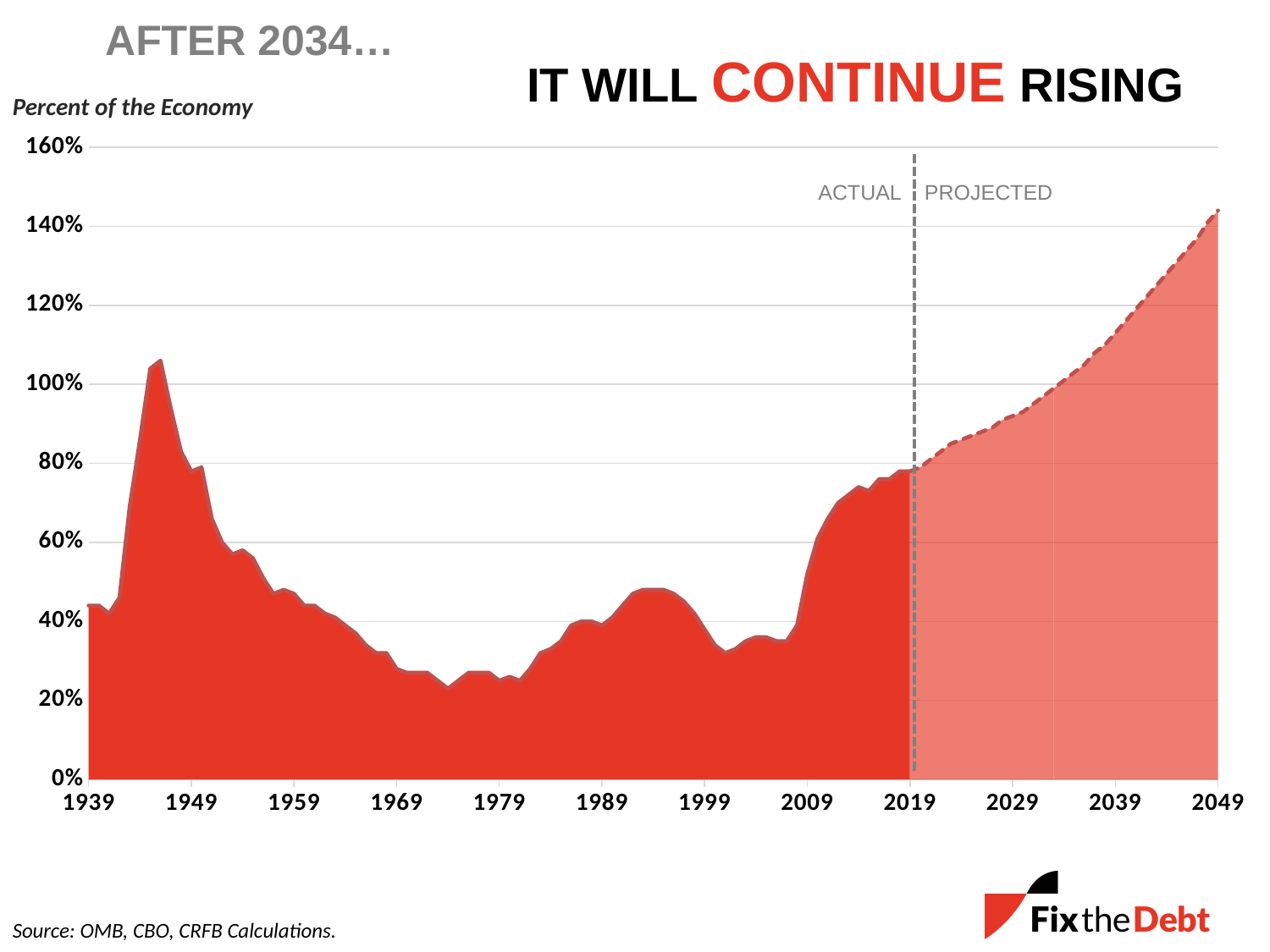
Do the values rise or fall from 2019 to 2049? rise At which year does the dashed vertical line separate the ACTUAL and PROJECTED sections? 2019 Is the value for 2019 greater or less than 100%? less Is the value for 1969 greater or less than 40%? less Is the projected value for 2029 greater or less than 100%? less What kind of chart is shown on the slide? Area chart In which year on the x axis does the chart reach its highest value? 2049 What is the label on the vertical axis of the chart? Percent of the Economy